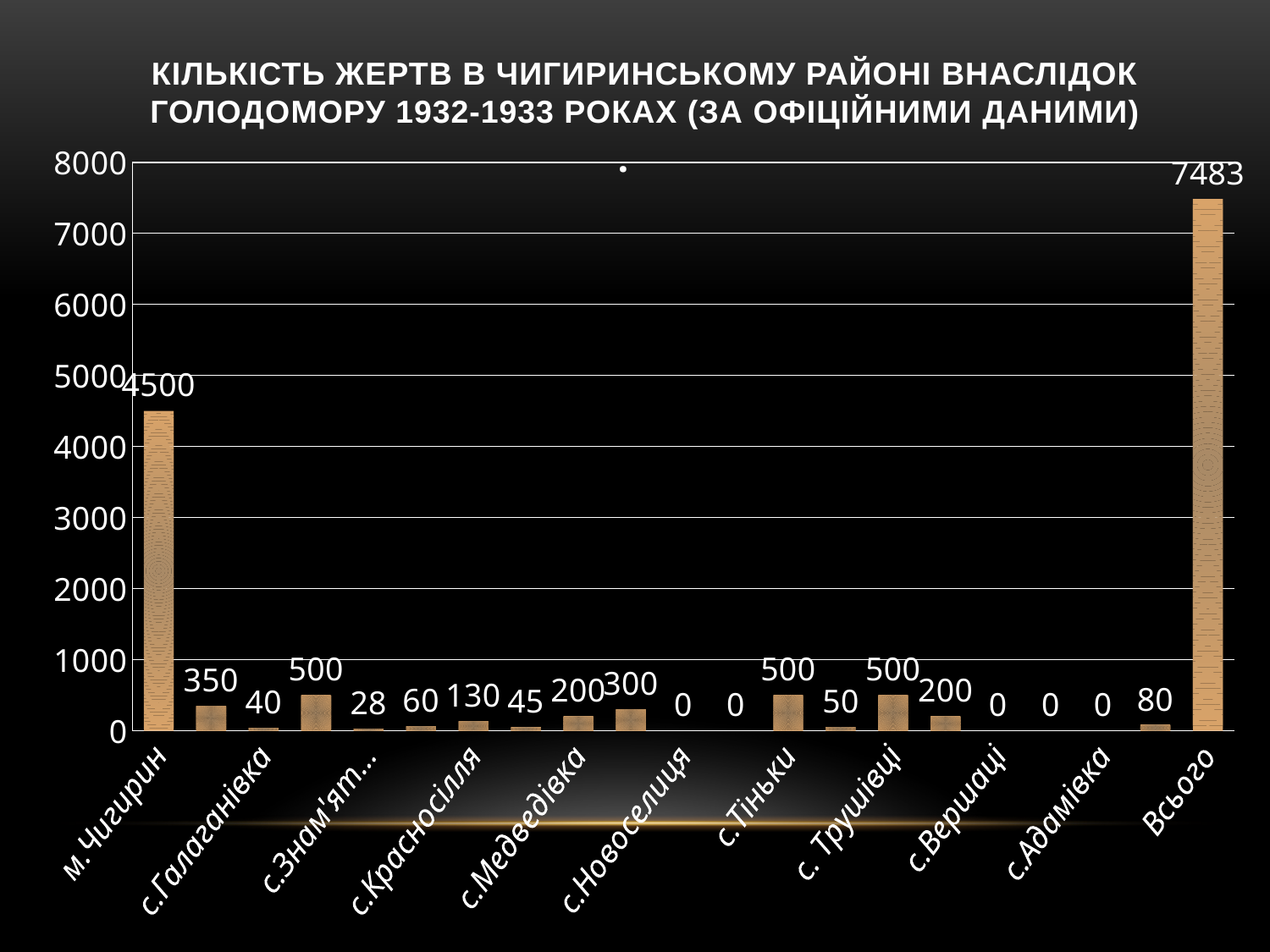
What is the value for с.Трушівці? 500 What type of chart is shown on the slide? bar chart Is the value for м.Чигирин greater or less than 4000? greater What is the value for Всього? 7483 Which category has the highest value? Всього What is the value for с.Адамівка? 0 Which is larger, the value for м.Чигирин or the value for с.Тіньки? м.Чигирин How many bars are plotted in the chart? 21 What is the difference between the values for Всього and м.Чигирин? 2983 What is the value for с.Новоселиця? 0 What is the value for с.Тіньки? 500 What is the value for м.Чигирин? 4500